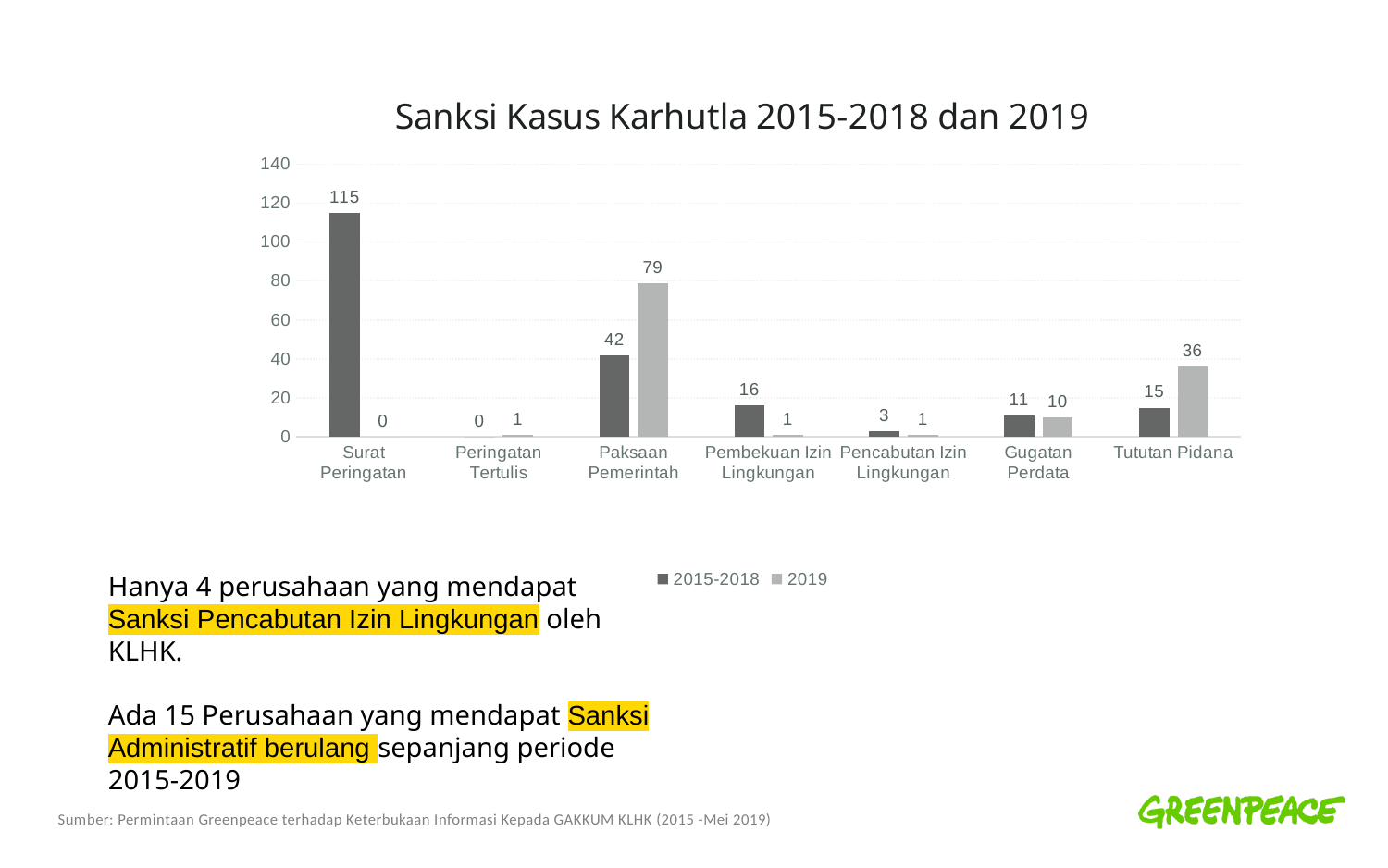
What kind of chart is shown on the slide? Bar chart Which is larger for Gugatan Perdata: the 2015-2018 value or the 2019 value? 2015-2018 Which category has the highest value in the 2015-2018 series? Surat Peringatan How many categories are shown on the x axis? 7 Which category has the highest value in the 2019 series? Paksaan Pemerintah What is the difference between the 2019 and 2015-2018 values for Paksaan Pemerintah? 37 How many series does the legend list? 2 What is the title of the chart? Sanksi Kasus Karhutla 2015-2018 dan 2019 What is the value for Pembekuan Izin Lingkungan in the 2019 series? 1 What is the value for Tututan Pidana in the 2015-2018 series? 15 What is the value for Surat Peringatan in the 2015-2018 series? 115 What is the value for Paksaan Pemerintah in the 2019 series? 79